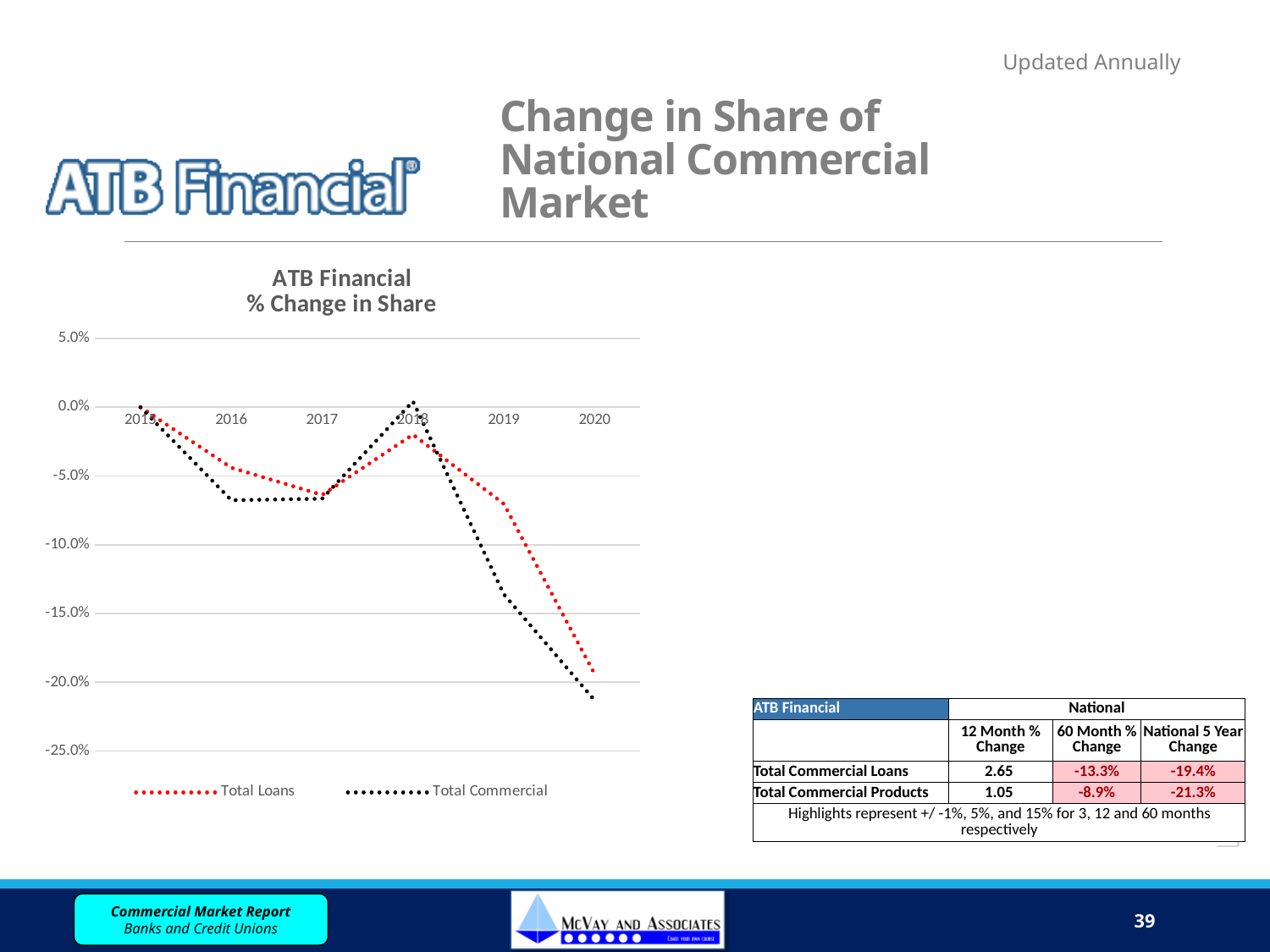
In the 'ATB Financial % Change in Share' chart, is the value for Total Commercial in 2016 greater or less than -5.0%? less In the 'ATB Financial % Change in Share' chart, is the value for Total Commercial in 2020 greater or less than -20.0%? less In the 'ATB Financial % Change in Share' chart, is the value for Total Loans in 2018 greater or less than -5.0%? greater How many years are shown on the x axis of the 'ATB Financial % Change in Share' chart? 6 In the 'ATB Financial % Change in Share' chart, which series has the higher value in 2016, Total Loans or Total Commercial? Total Loans In the 'ATB Financial % Change in Share' chart, which series has the lower value in 2020, Total Loans or Total Commercial? Total Commercial How many series does the legend of the 'ATB Financial % Change in Share' chart list? 2 What kind of chart is the 'ATB Financial % Change in Share' chart? line chart In the 'ATB Financial % Change in Share' chart, in which year is the Total Commercial series at its lowest? 2020 In the 'ATB Financial % Change in Share' chart, do the values for Total Commercial rise or fall from 2018 to 2020? fall